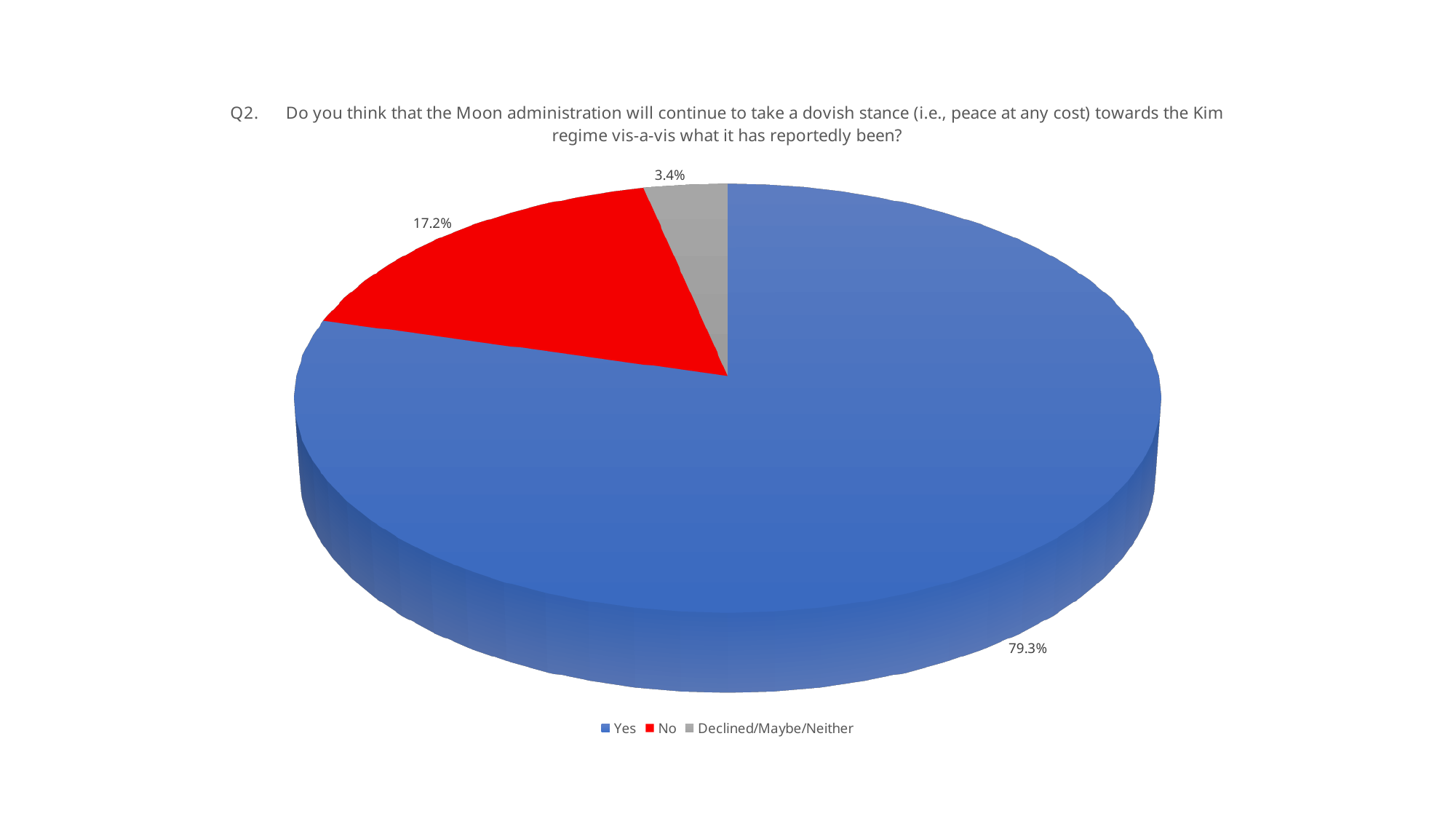
What is the difference in percentage points between the Yes and No shares? 62.1 What colour is the slice for No? red How many categories does the legend list? 3 Which response has the smallest share of the pie? Declined/Maybe/Neither What percentage of respondents answered Yes? 79.3% What percentage of respondents answered No? 17.2% What kind of chart is shown on the slide? pie chart Which response has the largest share of the pie? Yes What is the difference in percentage points between the No and Declined/Maybe/Neither shares? 13.8 What percentage of respondents are in the Declined/Maybe/Neither category? 3.4% Which is larger, the share for No or the share for Declined/Maybe/Neither? No What colour is the slice for Yes? blue